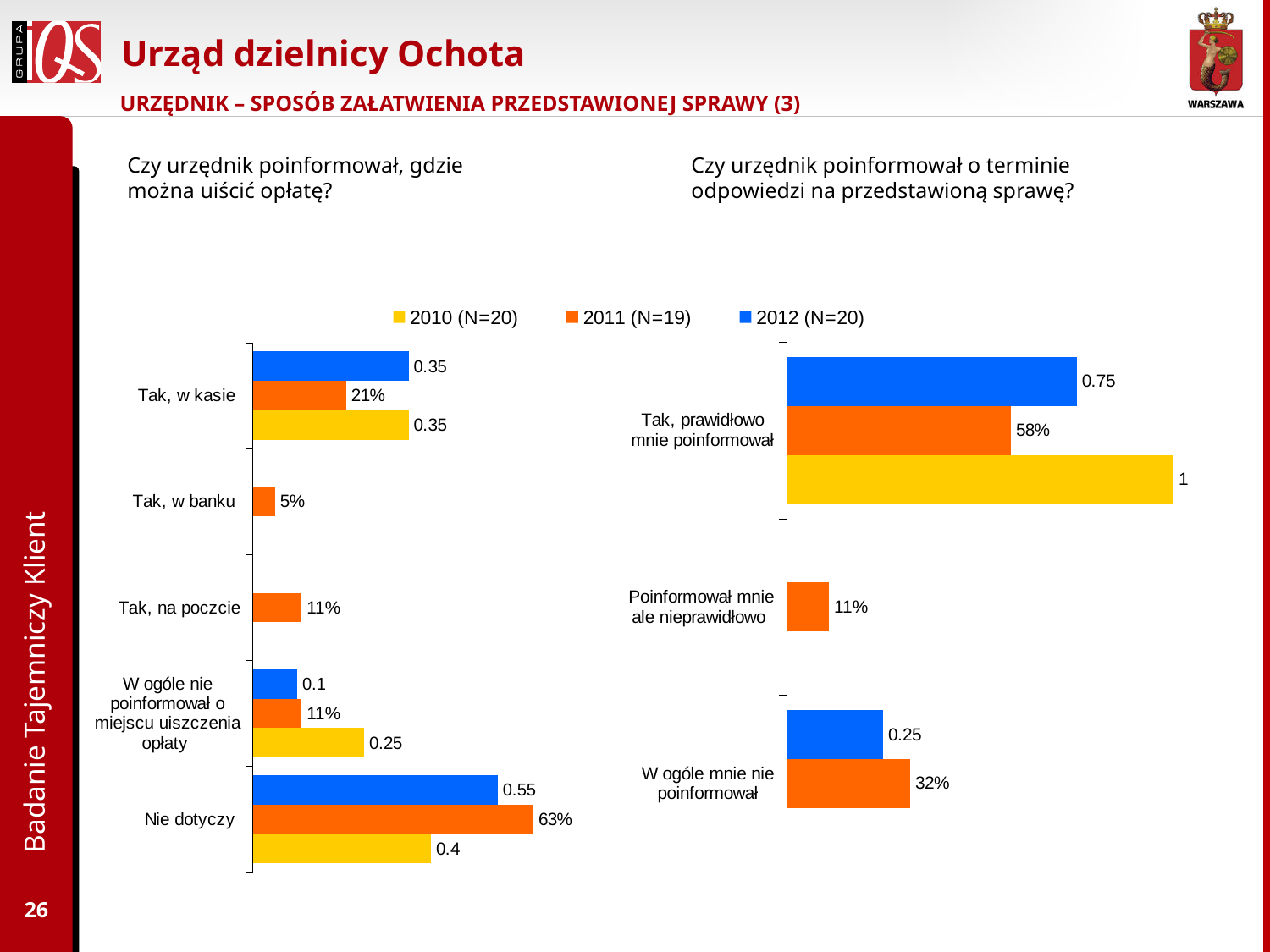
In the left chart (Czy urzędnik poinformował, gdzie można uiścić opłatę?), how many categories are shown? 5 In the left chart (Czy urzędnik poinformował, gdzie można uiścić opłatę?), what is the 2012 (N=20) value for 'Nie dotyczy'? 0.55 In the right chart (Czy urzędnik poinformował o terminie odpowiedzi na przedstawioną sprawę?), what is the 2010 (N=20) value for 'Tak, prawidłowo mnie poinformował'? 1 In the right chart (Czy urzędnik poinformował o terminie odpowiedzi na przedstawioną sprawę?), what is the 2011 (N=19) value for 'Tak, prawidłowo mnie poinformował'? 58% In the left chart (Czy urzędnik poinformował, gdzie można uiścić opłatę?), what is the 2011 (N=19) value for 'Tak, w kasie'? 21% In the right chart (Czy urzędnik poinformował o terminie odpowiedzi na przedstawioną sprawę?), what is the 2011 (N=19) value for 'W ogóle mnie nie poinformował'? 32% How many series does the legend list? 3 In the left chart (Czy urzędnik poinformował, gdzie można uiścić opłatę?), which category has the lowest 2011 (N=19) value? Tak, w banku In the left chart (Czy urzędnik poinformował, gdzie można uiścić opłatę?), what is the 2010 (N=20) value for 'W ogóle nie poinformował o miejscu uiszczenia opłaty'? 0.25 In the left chart (Czy urzędnik poinformował, gdzie można uiścić opłatę?), which category has the highest 2011 (N=19) value? Nie dotyczy In the right chart (Czy urzędnik poinformował o terminie odpowiedzi na przedstawioną sprawę?), which is larger for 'Tak, prawidłowo mnie poinformował': the 2012 (N=20) value or the 2011 (N=19) value? 2012 (N=20) What type of chart is used on this slide? Bar chart